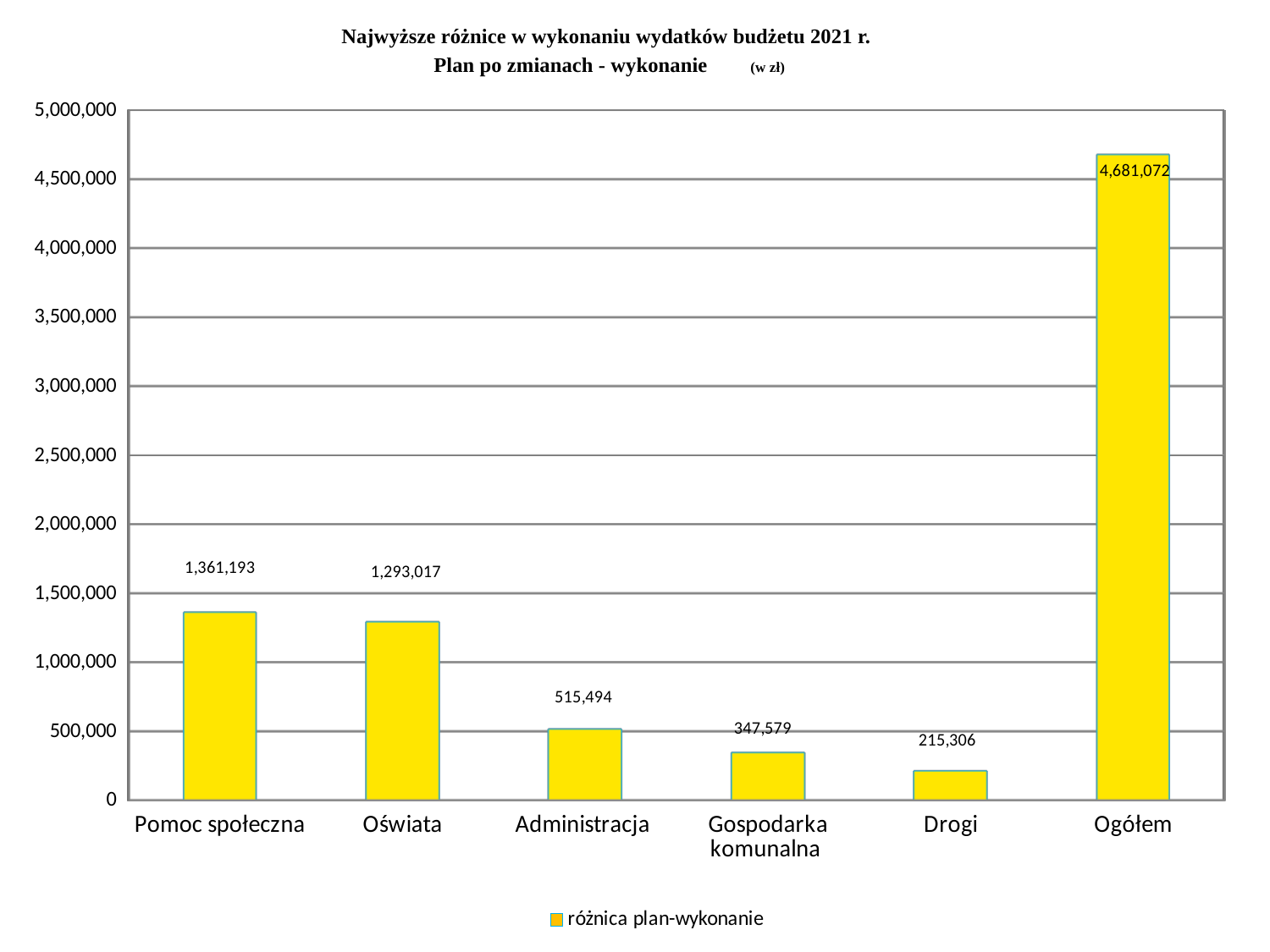
What is the value for Ogółem? 4,681,072 What is the difference between the values for Pomoc społeczna and Oświata? 68,176 What is the legend entry for the series? różnica plan-wykonanie Which is larger, the value for Gospodarka komunalna or the value for Drogi? Gospodarka komunalna How many categories are shown on the x axis? 6 Which category has the highest value? Ogółem What is the value for Drogi? 215,306 What is the value for Pomoc społeczna? 1,361,193 What kind of chart is this? Bar chart Which category has the lowest value? Drogi What is the difference between the values for Administracja and Drogi? 300,188 What is the value for Oświata? 1,293,017